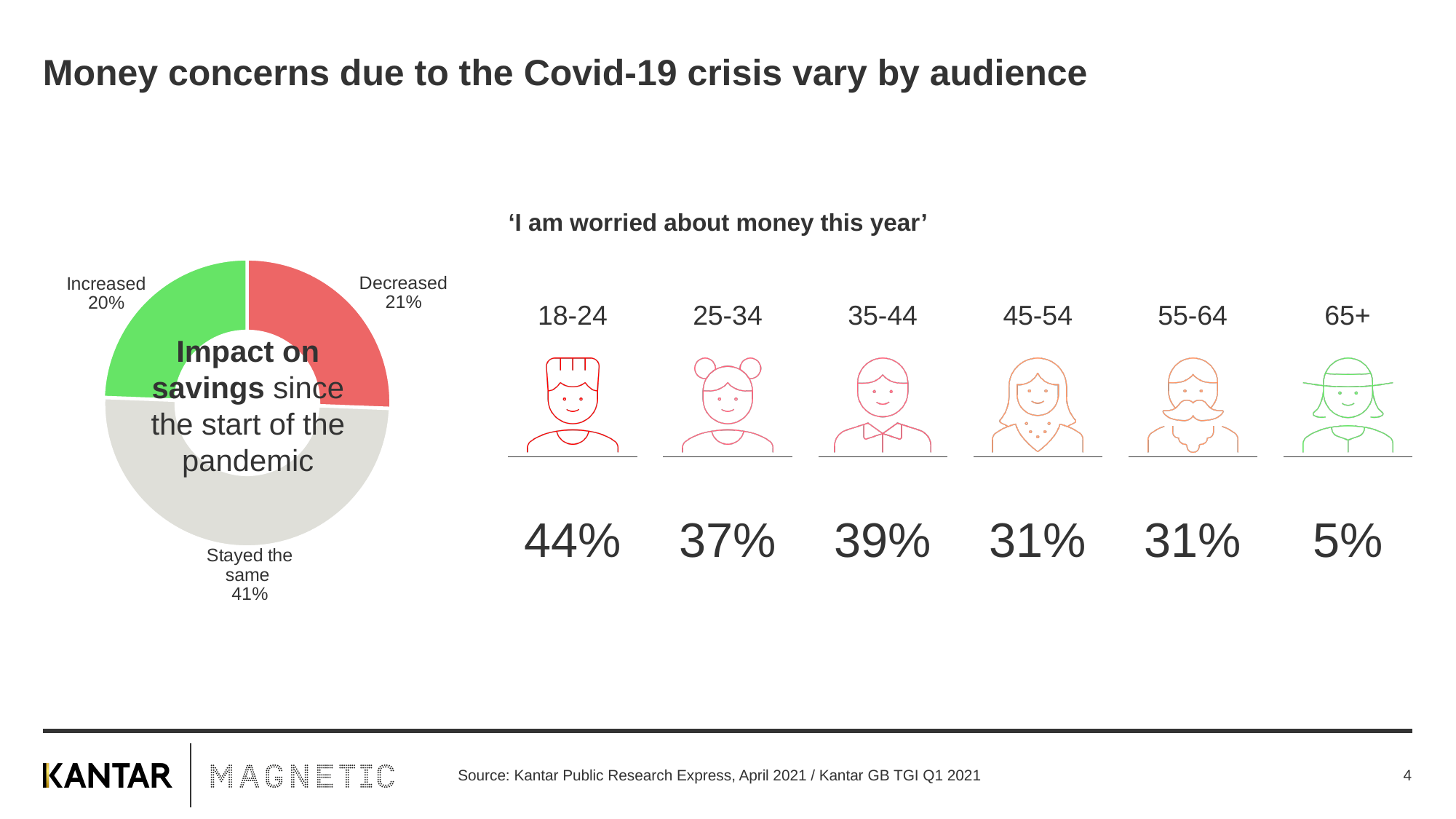
In the 'Impact on savings' chart, which is larger: 'Increased' or 'Decreased'? Decreased In the 'Impact on savings' chart, what percentage of respondents said their savings stayed the same? 41% What type of chart is the 'Impact on savings' chart? Donut chart In the 'Impact on savings' chart, what percentage said their savings decreased? 21% In the 'Impact on savings' chart, what percentage said their savings increased? 20% In the 'Impact on savings' chart, which category has the largest share? Stayed the same How many categories does the 'Impact on savings' chart show? 3 In the 'I am worried about money this year' graphic, which age group has the lowest percentage? 65+ In the 'Impact on savings' chart, which category has the smallest share? Increased In the 'Impact on savings' chart, what is the difference in percentage points between 'Stayed the same' and 'Decreased'? 20 percentage points In the 'Impact on savings' chart, what colour is the 'Increased' segment? Green In the 'I am worried about money this year' graphic, what percentage is shown for the 18-24 age group? 44%